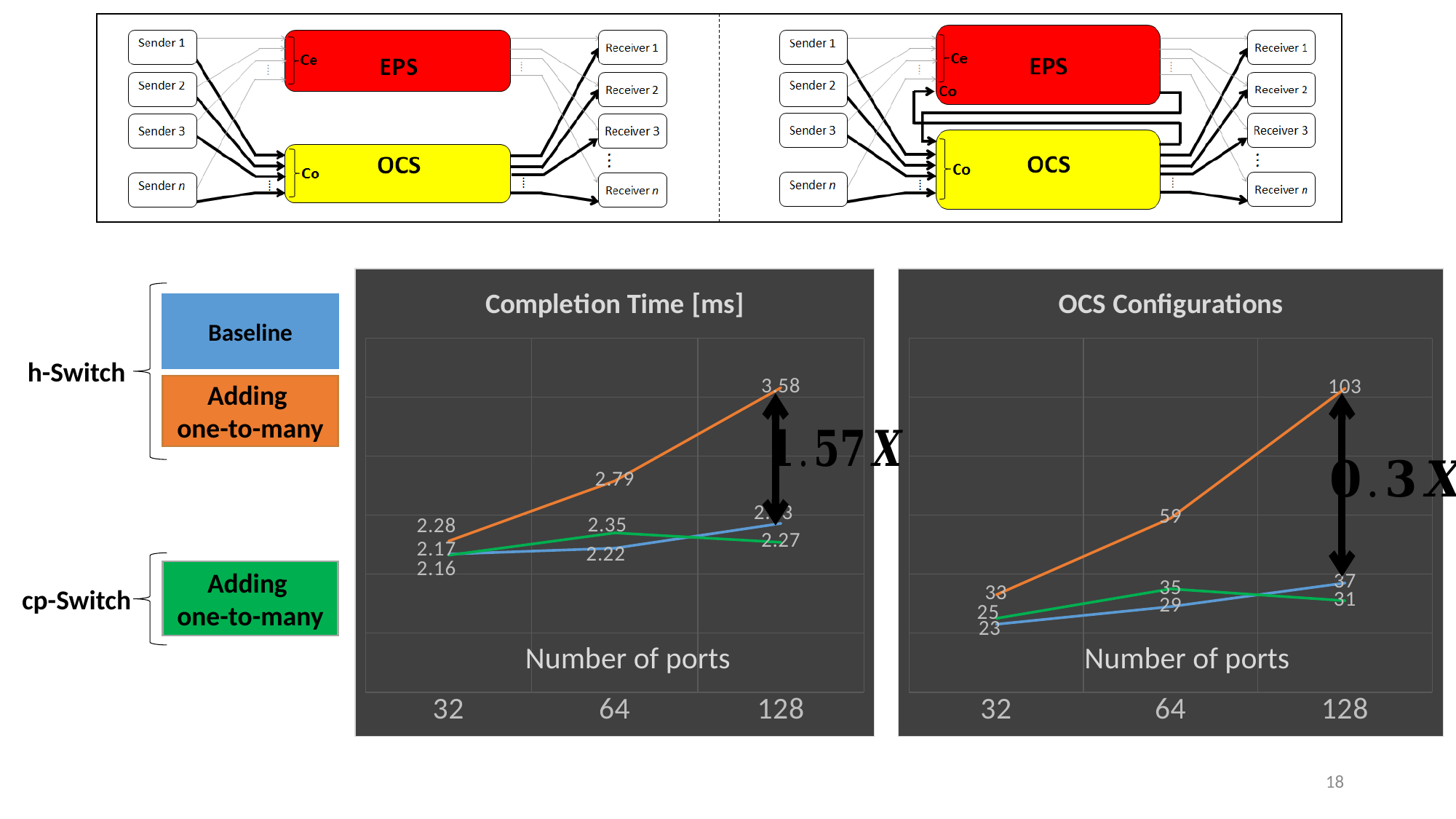
In the Completion Time [ms] chart, what is the difference between the h-Switch 'Adding one-to-many' values at 128 ports and 32 ports? 1.30 In the OCS Configurations chart, what is the value of the h-Switch 'Adding one-to-many' (orange) line at 128 ports? 103 In the OCS Configurations chart at 128 ports, which is larger: the Baseline value or the cp-Switch 'Adding one-to-many' value? Baseline How many port counts are shown on the x axis of the Completion Time [ms] chart? 3 What type of chart is the OCS Configurations chart? line chart In the OCS Configurations chart, by how much does the h-Switch 'Adding one-to-many' value increase from 64 ports to 128 ports? 44 In the OCS Configurations chart, what is the Baseline value at 64 ports? 29 In the Completion Time [ms] chart, does the h-Switch 'Adding one-to-many' (orange) line rise or fall as the number of ports increases? rises In the Completion Time [ms] chart, what is the Baseline value at 32 ports? 2.17 In the Completion Time [ms] chart, what is the value of the h-Switch 'Adding one-to-many' (orange) line at 128 ports? 3.58 In the Completion Time [ms] chart, what is the value of the cp-Switch 'Adding one-to-many' (green) line at 64 ports? 2.35 In the OCS Configurations chart, what is the value of the cp-Switch 'Adding one-to-many' (green) line at 128 ports? 31